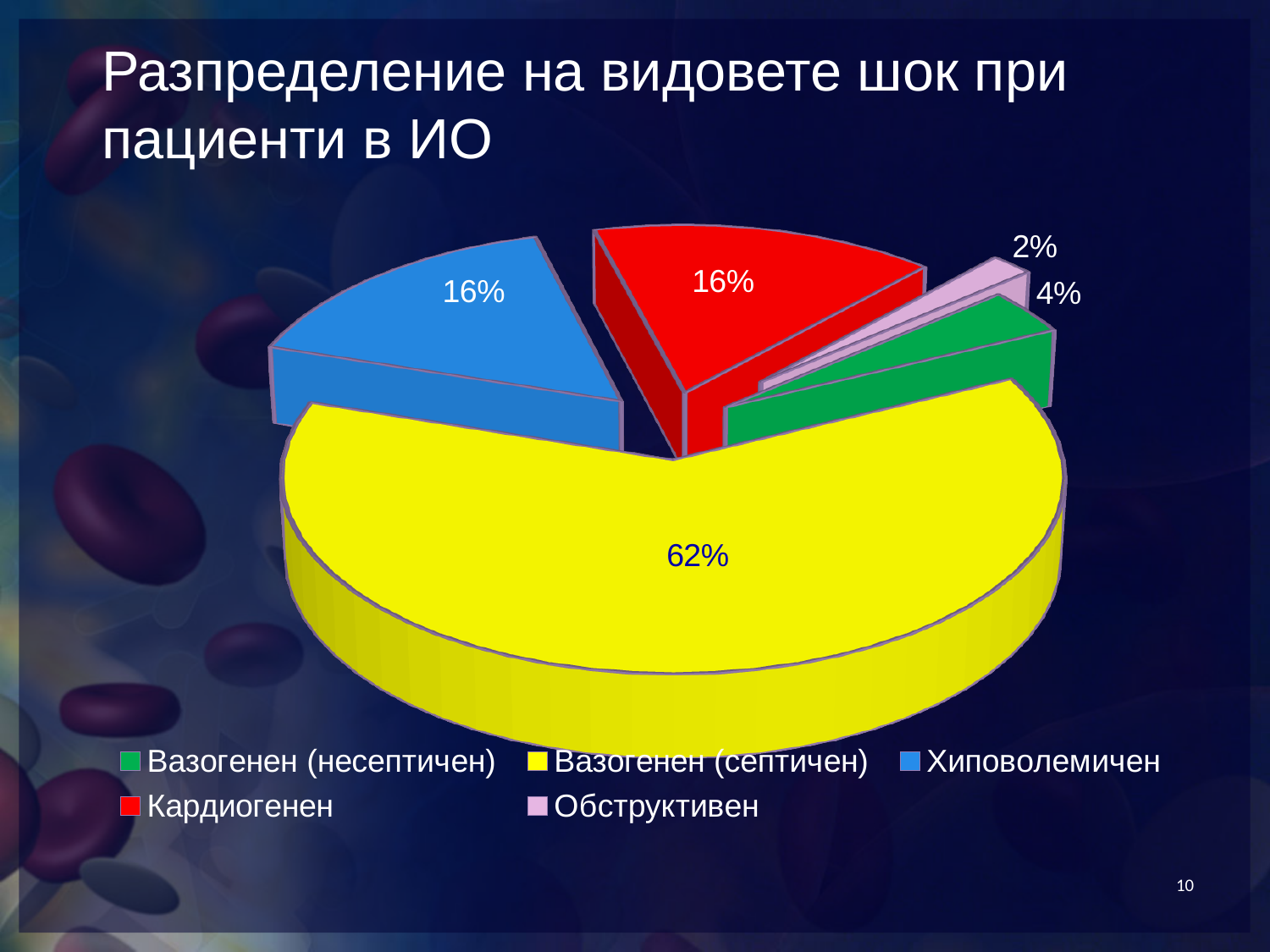
What share of the pie does Вазогенен (несептичен) have? 4% What share of the pie does Кардиогенен have? 16% What kind of chart is shown on the slide? pie chart Which category has the smallest slice of the pie? Обструктивен What share of the pie does Хиповолемичен have? 16% How many categories does the pie chart have? 5 What is the difference between the shares of Вазогенен (септичен) and Хиповолемичен? 46% Which category has the largest slice of the pie? Вазогенен (септичен) What share of the pie does Обструктивен have? 2% What share of the pie does Вазогенен (септичен) have? 62% Which is larger, the share of Вазогенен (несептичен) or the share of Обструктивен? Вазогенен (несептичен) What colour is the slice for Кардиогенен? red